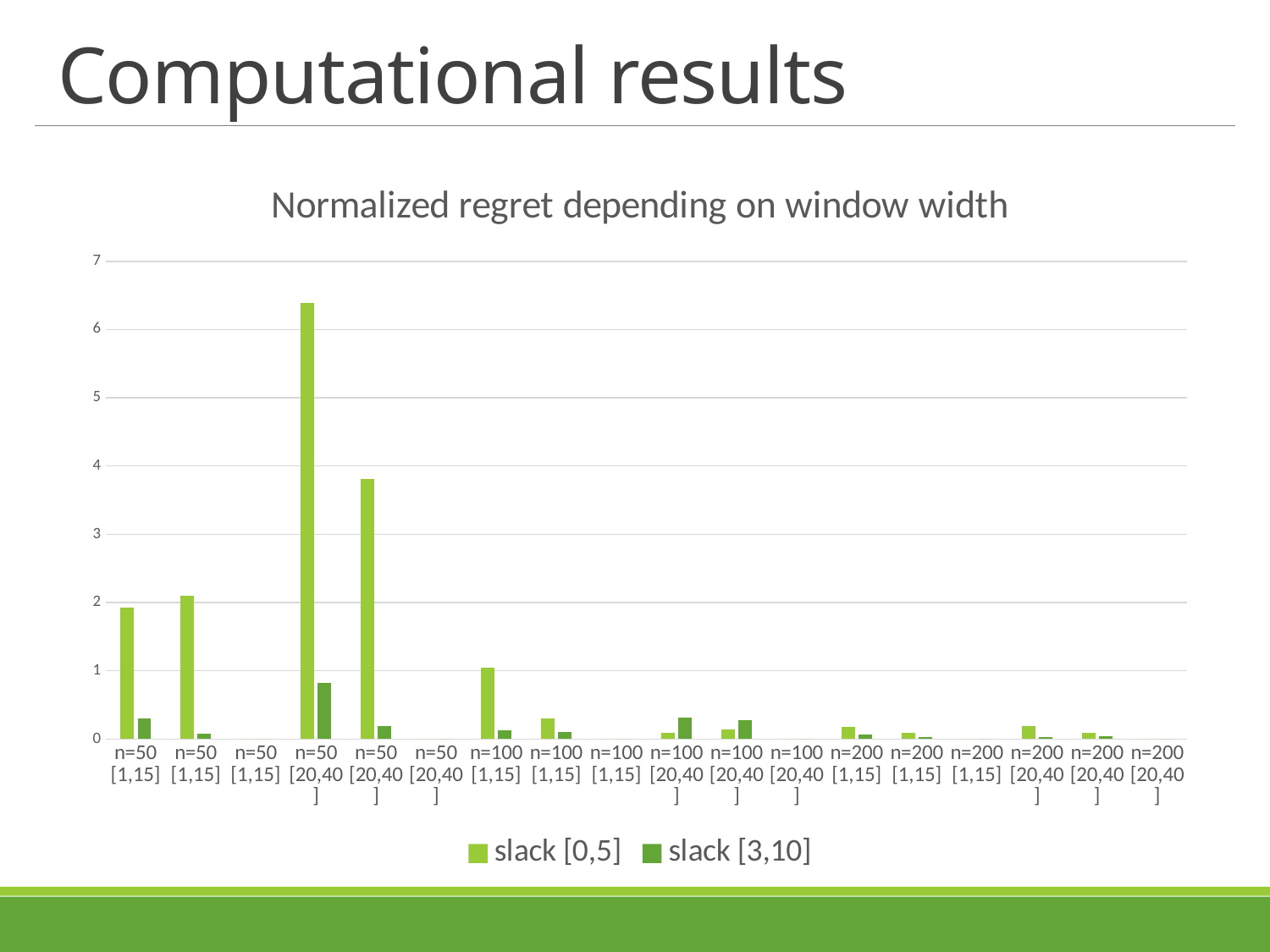
Which series contains the tallest bar in the chart? slack [0,5] How many category groups are shown along the x axis? 18 Is the slack [0,5] value in the fifth group from the left (n=50 [20,40]) greater or less than 3? greater Is the tallest bar in the chart (slack [0,5] in the fourth group from the left, n=50 [20,40]) greater or less than 6? greater What is the title of the chart? Normalized regret depending on window width In the tenth group from the left (the first n=100 [20,40] group), which series has the larger value, slack [0,5] or slack [3,10]? slack [3,10] Is the slack [0,5] value in the first group from the left (n=50 [1,15]) greater or less than 2? less How many series does the legend list? 2 What kind of chart is shown on the slide? bar chart What are the two series named in the legend? slack [0,5] and slack [3,10] In the fourth group from the left (n=50 [20,40]), which series has the larger value, slack [0,5] or slack [3,10]? slack [0,5]